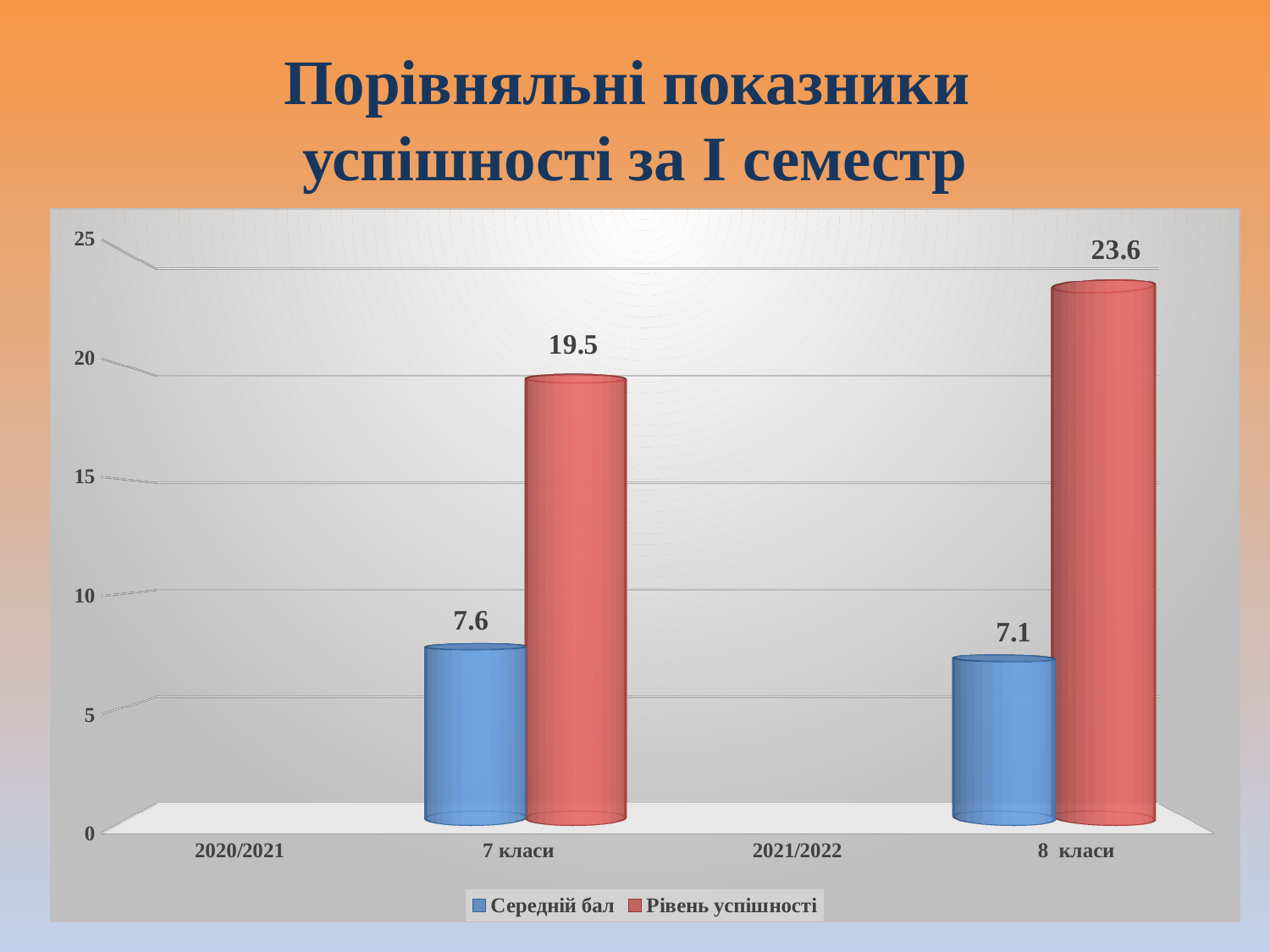
What is the value of Середній бал for 7 класи? 7.6 What is the difference between the Середній бал values for 7 класи and 8 класи? 0.5 Which category has the lowest Середній бал value? 8 класи Which is larger: Рівень успішності for 7 класи or for 8 класи? 8 класи What is the difference between the Рівень успішності values for 8 класи and 7 класи? 4.1 What is the value of Середній бал for 8 класи? 7.1 What is the value of Рівень успішності for 8 класи? 23.6 Which category has the highest Рівень успішності value? 8 класи Is the Рівень успішності value for 7 класи greater or less than 20? less How many series does the legend list? 2 What is the value of Рівень успішності for 7 класи? 19.5 What kind of chart is shown on the slide? bar chart